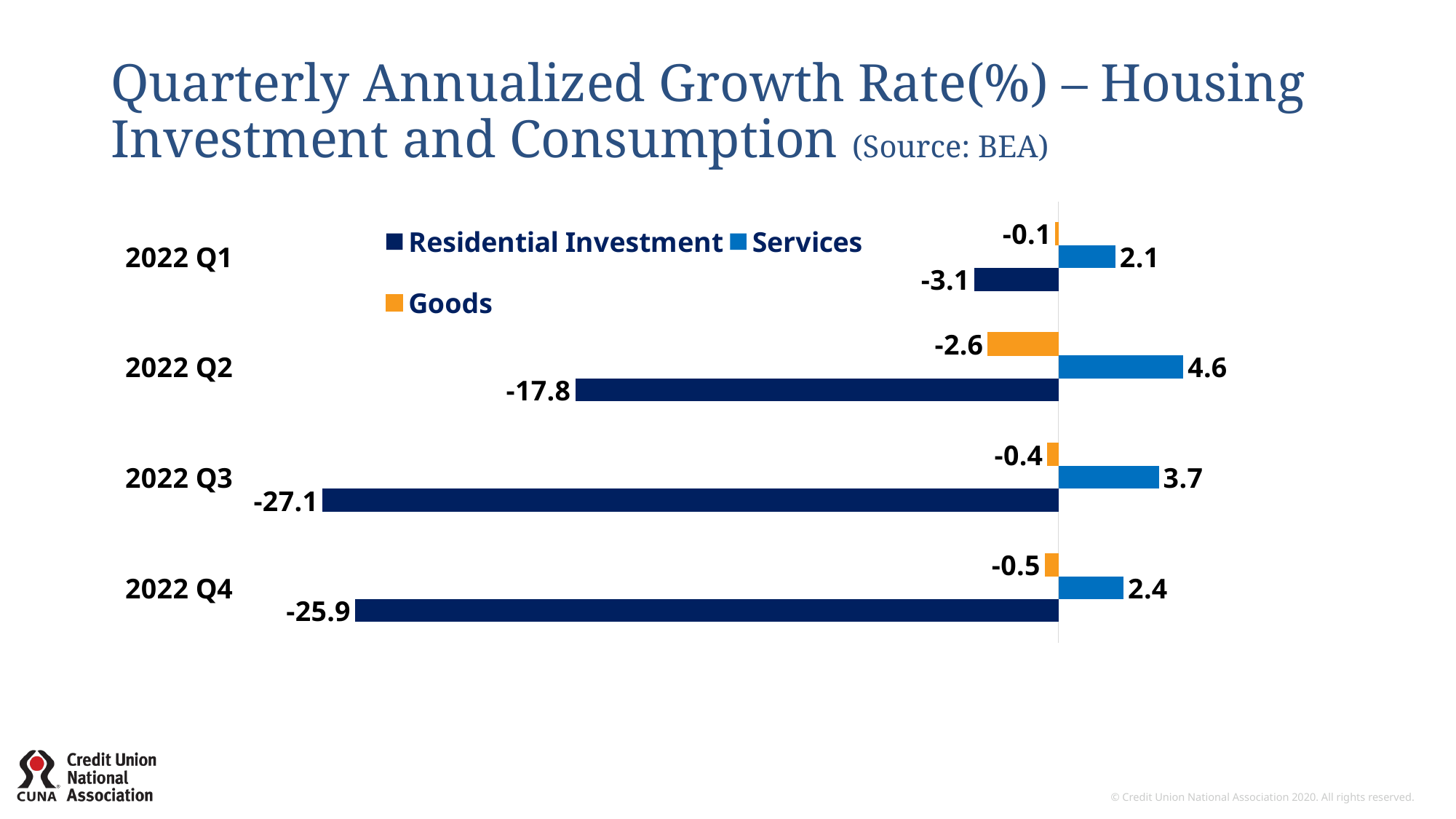
What kind of chart is shown on the slide? Bar chart How many series does the legend list? 3 In which quarter is the Residential Investment value lowest? 2022 Q3 What is the Residential Investment value for 2022 Q1? -3.1 Which series is shown in orange in the legend? Goods How many quarters are shown on the chart? 4 In which quarter is the Services value highest? 2022 Q2 What is the Services value for 2022 Q2? 4.6 Which is larger, the Services value for 2022 Q1 or for 2022 Q3? 2022 Q3 What is the difference between the Services values for 2022 Q2 and 2022 Q4? 2.2 What is the Residential Investment value for 2022 Q3? -27.1 What is the Goods value for 2022 Q4? -0.5